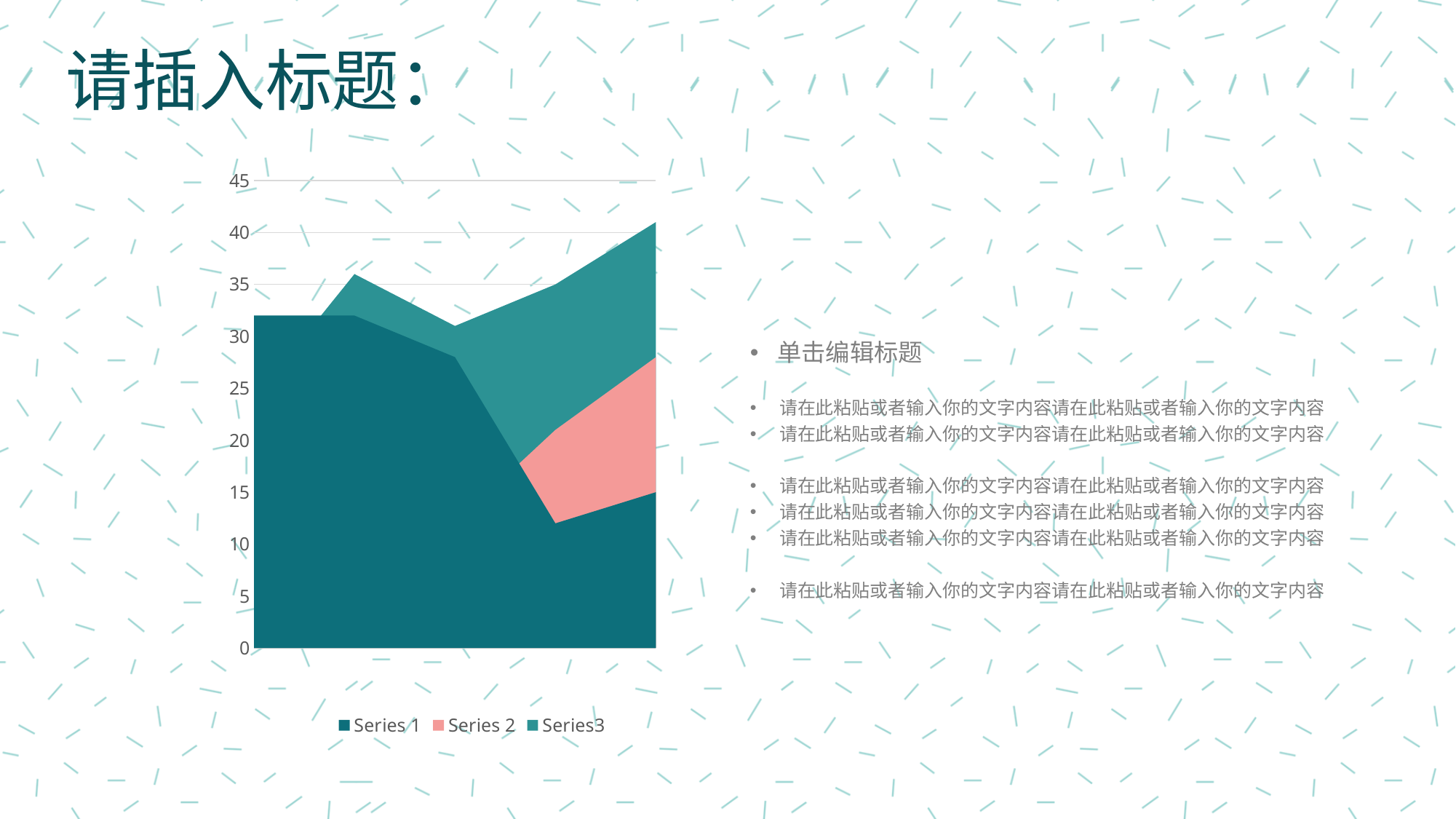
What is the highest value shown on the chart's vertical axis? 45 Is the value for Series 1 at the leftmost point greater or less than 30? greater What colour represents Series 2 in the chart? pink What kind of chart is shown on the slide? area chart How many series does the chart legend list? 3 How many data points does each series in the chart have? 5 Does the value of Series 1 overall rise or fall from the left of the chart to the right? fall What are the names of the series listed in the chart legend? Series 1, Series 2, Series3 Is the value for Series 1 at the rightmost point greater or less than 20? less